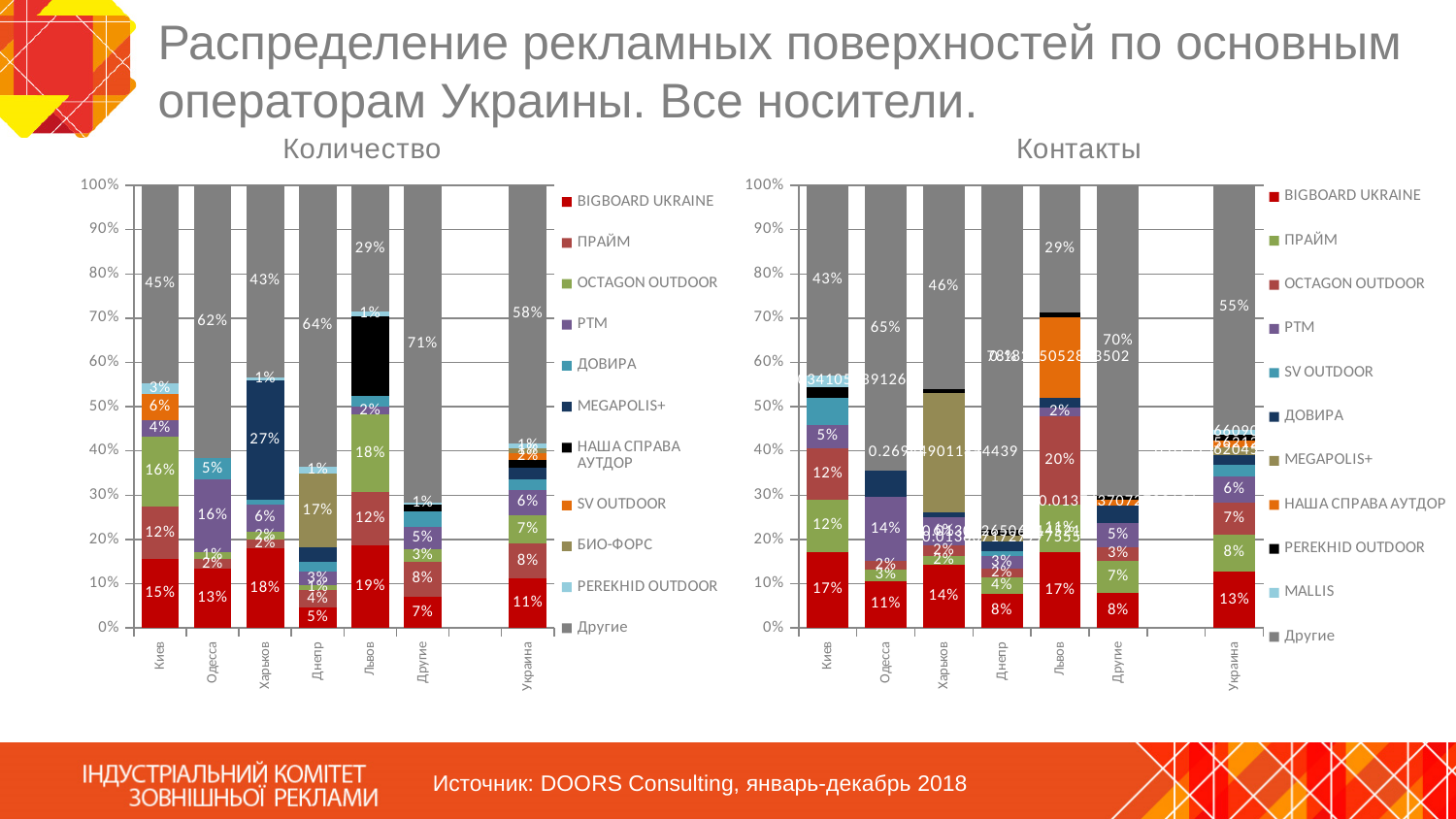
In the "Количество" chart, what is the "Другие" share for Другие? 71% In the "Контакты" chart, what is the BIGBOARD UKRAINE share for Львов? 17% In the "Контакты" chart, what is the ПРАЙМ share for Львов? 11% In the "Контакты" chart, what is the "Другие" share for Украина? 55% In the "Количество" chart, what is the difference between the "Другие" share for Другие and for Киев? 26% In the "Количество" chart, what is the MEGAPOLIS+ share for Харьков? 27% How many categories are shown on the x axis of the "Контакты" chart? 7 What kind of charts are shown on the slide? Stacked bar charts How many series does the legend of the "Количество" chart list? 11 In the "Количество" chart, what is the BIGBOARD UKRAINE share for Киев? 15% In the "Количество" chart, which city has the larger BIGBOARD UKRAINE share, Львов or Днепр? Львов In the "Количество" chart, what is the "Другие" share for Украина? 58%